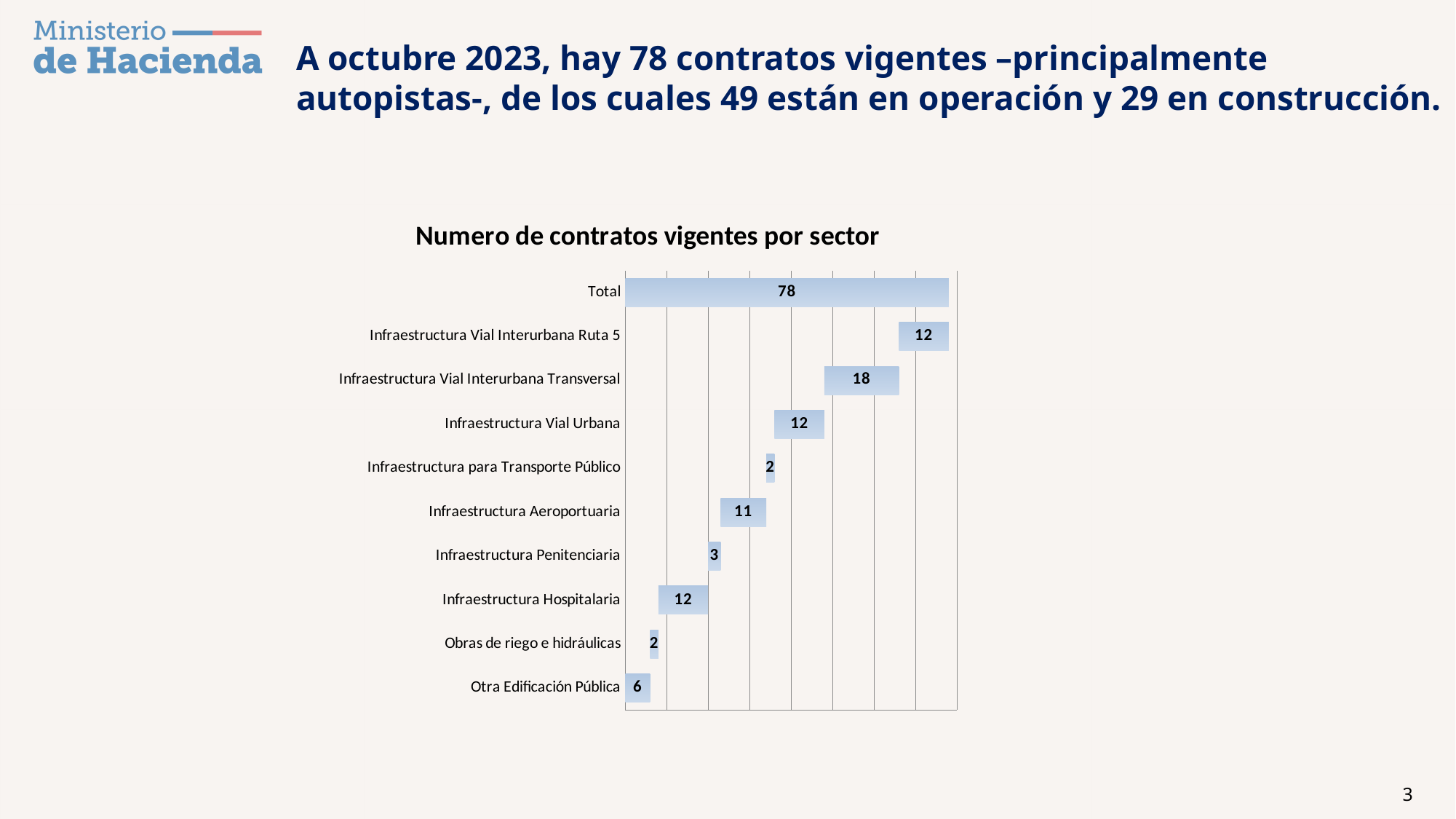
How many contracts are shown for Infraestructura Vial Interurbana Transversal? 18 Excluding the Total bar, which sector has the highest number of contracts? Infraestructura Vial Interurbana Transversal What is the difference between the values for Infraestructura Hospitalaria and Infraestructura Penitenciaria? 9 How many bars are shown in the chart, including the Total bar? 10 What kind of chart is shown on the slide? Bar chart What is the value shown for Total in the chart? 78 What is the value for Otra Edificación Pública? 6 What is the value for Infraestructura Penitenciaria? 3 What is the difference between the values for Infraestructura Vial Interurbana Transversal and Infraestructura Vial Interurbana Ruta 5? 6 Which is larger, the value for Infraestructura Aeroportuaria or the value for Infraestructura Vial Urbana? Infraestructura Vial Urbana What is the title of the chart? Numero de contratos vigentes por sector What is the value for Infraestructura Aeroportuaria? 11